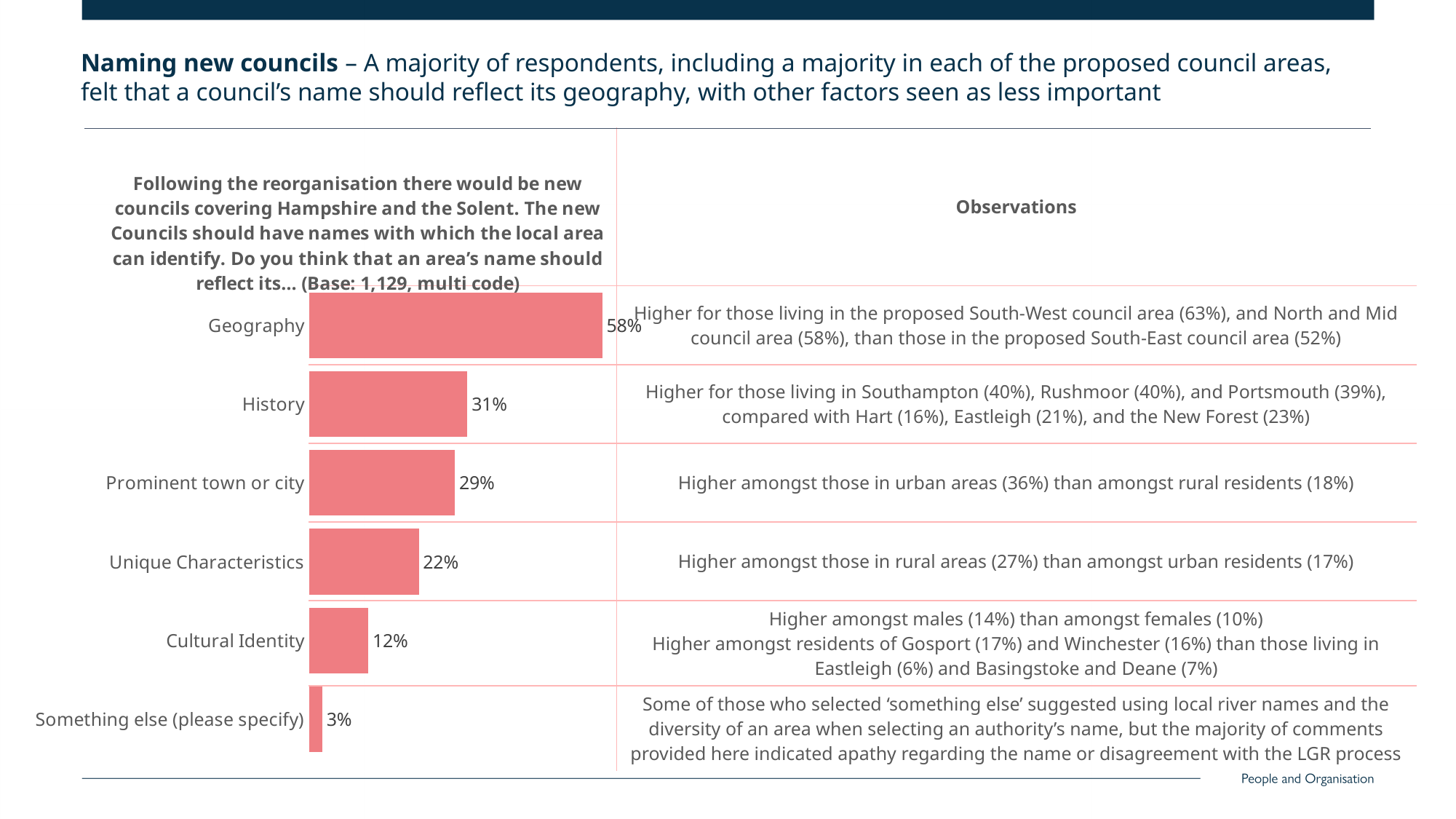
What is the value shown for History? 31% What percentage is shown for Prominent town or city? 29% What is the difference between the values for Geography and History? 27% How many categories are shown in the chart? 6 What type of chart is shown on the slide? Bar chart Which has a higher value, Unique Characteristics or Cultural Identity? Unique Characteristics Which category has the lowest value in the chart? Something else (please specify) What is the base (number of respondents) stated in the chart title? 1,129 What is the value for Cultural Identity? 12% What percentage of respondents said an area's name should reflect its Geography? 58% What is the difference between the values for Unique Characteristics and Cultural Identity? 10% Which category has the highest value in the chart? Geography